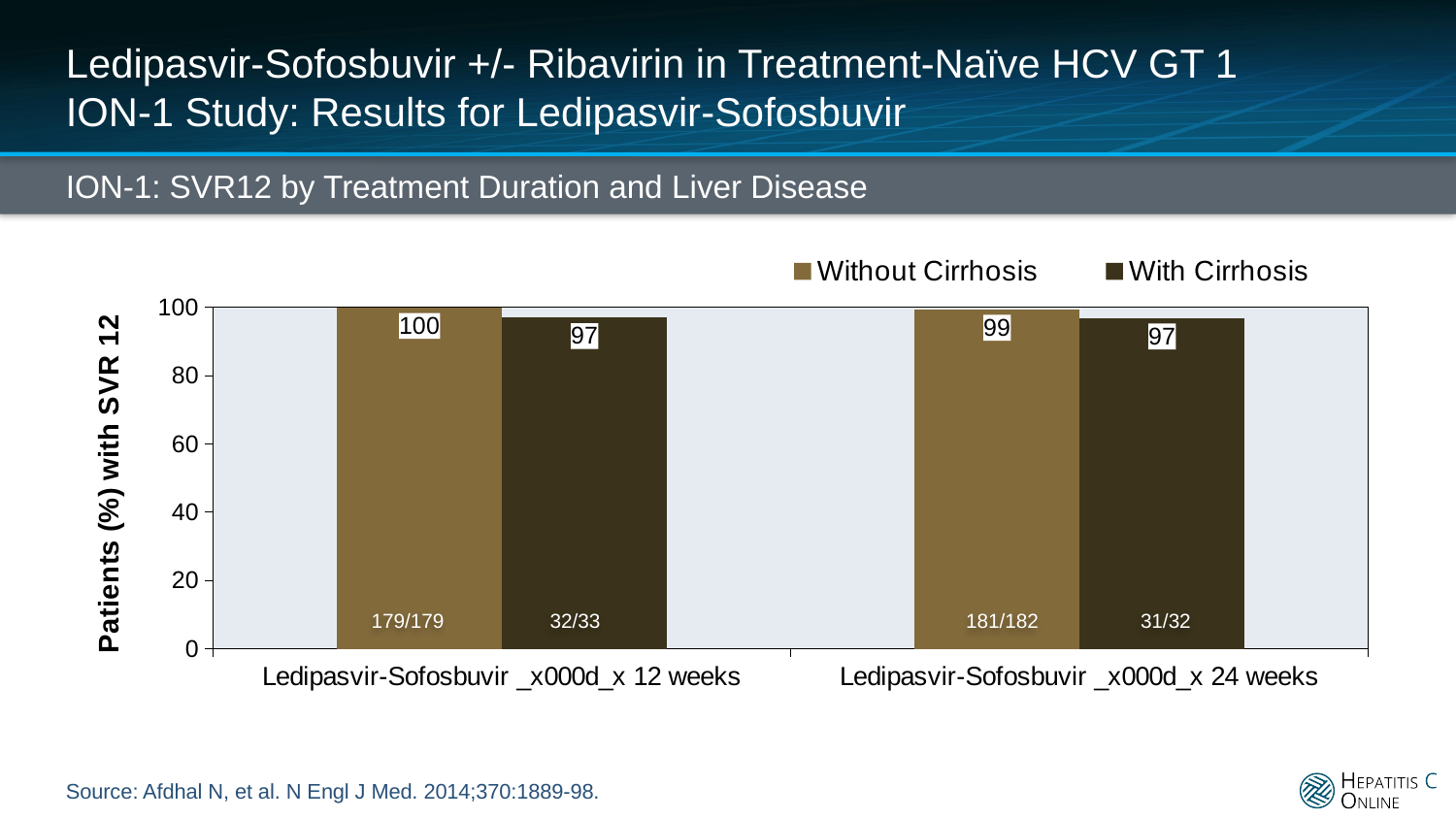
What fraction of patients is shown inside the bar for patients with cirrhosis treated for 12 weeks? 32/33 What fraction of patients is shown inside the bar for patients without cirrhosis treated for 24 weeks? 181/182 What is the SVR12 rate for patients without cirrhosis treated with Ledipasvir-Sofosbuvir for 24 weeks? 99 What kind of chart is shown on the slide? Bar chart Which is larger: the SVR12 for patients without cirrhosis at 24 weeks or with cirrhosis at 24 weeks? Without Cirrhosis What is the difference in SVR12 between patients without cirrhosis and with cirrhosis in the 12-week group? 3 What is the label of the y-axis? Patients (%) with SVR 12 Which bar has the highest SVR12 value? Without Cirrhosis, Ledipasvir-Sofosbuvir 12 weeks What is the SVR12 rate for patients without cirrhosis treated with Ledipasvir-Sofosbuvir for 12 weeks? 100 How many series does the legend list? 2 What is the SVR12 rate for patients with cirrhosis treated with Ledipasvir-Sofosbuvir for 24 weeks? 97 What is the difference in SVR12 between patients without cirrhosis in the 12-week group and the 24-week group? 1